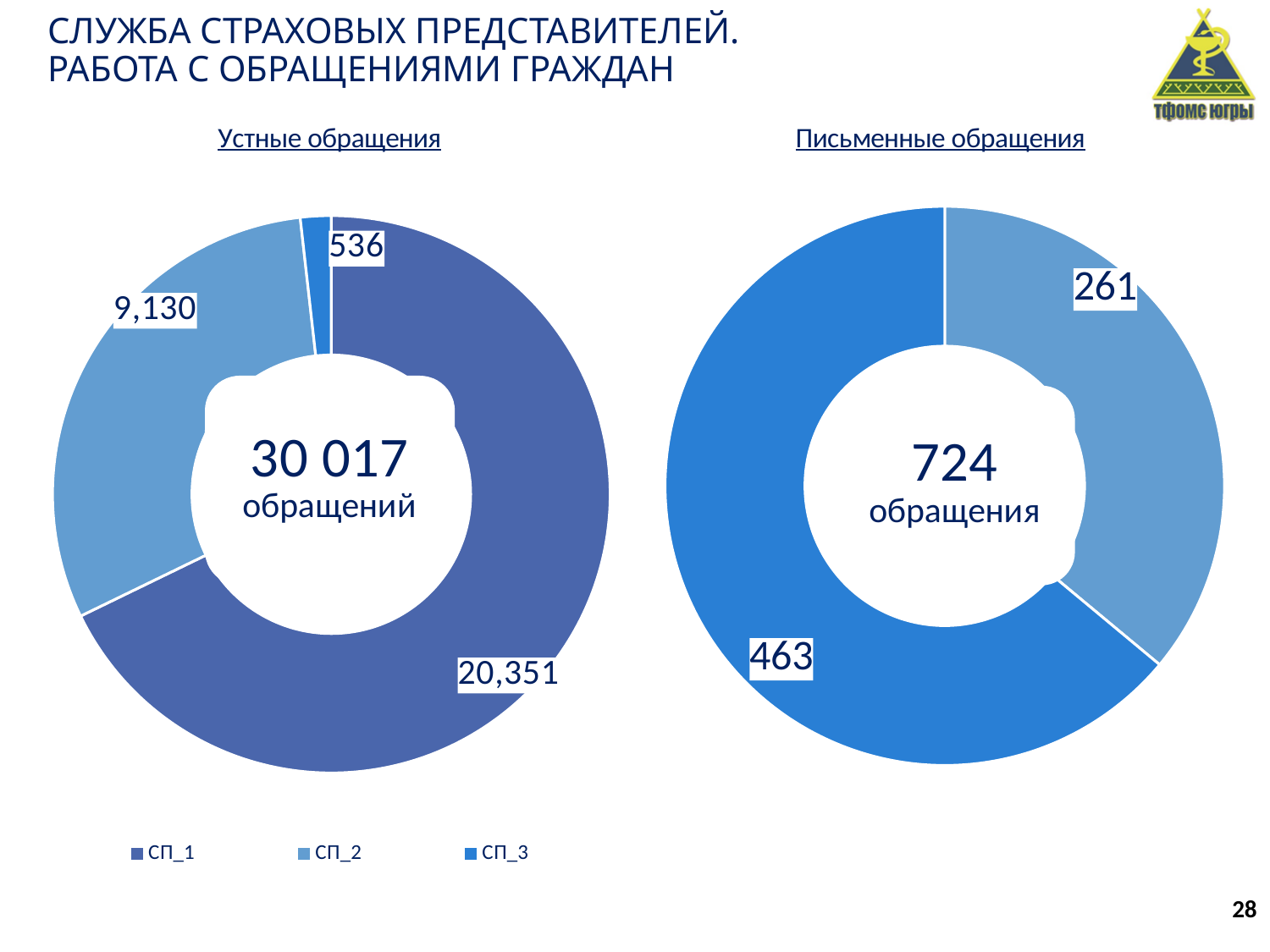
What type of chart is used for Устные обращения? Donut (pie) chart On the Письменные обращения chart, which is larger: the slice labelled 463 or the slice labelled 261? 463 On the Устные обращения chart, which category has the largest value? СП_1 On the Устные обращения chart, which category has the smallest value? СП_3 On the Письменные обращения chart, what is the difference between the two slice values? 202 What total number of appeals is shown in the centre of the Устные обращения chart? 30 017 On the Устные обращения chart, what is the value for СП_1? 20,351 On the Устные обращения chart, what is the difference between the values for СП_1 and СП_2? 11,221 How many slices does the Письменные обращения chart have? 2 On the Устные обращения chart, what is the value for СП_3? 536 What total number of appeals is shown in the centre of the Письменные обращения chart? 724 On the Устные обращения chart, what is the value for СП_2? 9,130